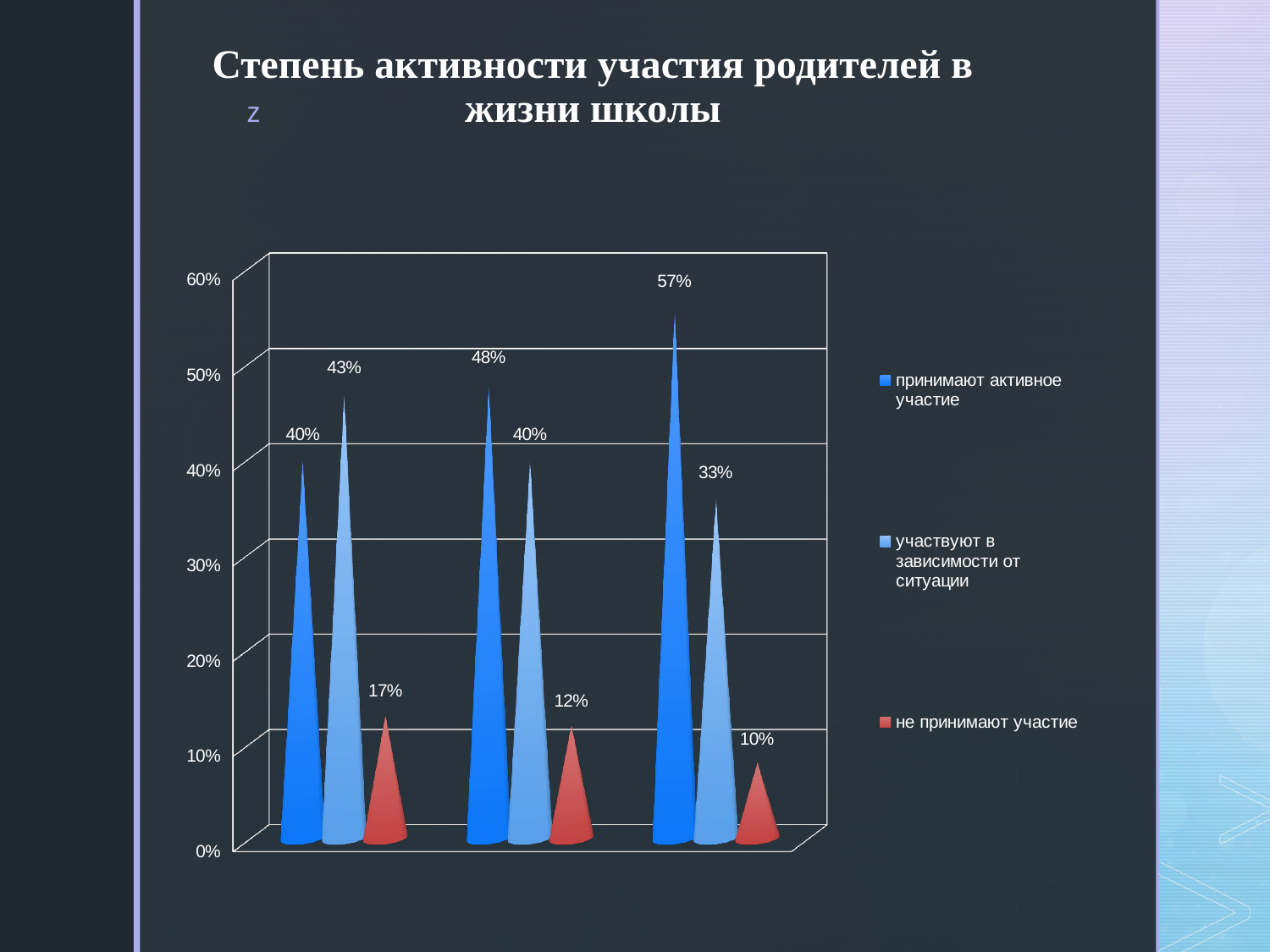
What is the lowest value shown for 'не принимают участие'? 10% Do the values for 'принимают активное участие' rise or fall from the left group to the right group? rise What is the value for 'принимают активное участие' in the third (rightmost) group of bars? 57% What kind of chart is shown on the slide? bar chart How many series does the legend list? 3 What is the value for 'участвуют в зависимости от ситуации' in the second (middle) group of bars? 40% In the first (leftmost) group, which is larger: 'принимают активное участие' or 'участвуют в зависимости от ситуации'? участвуют в зависимости от ситуации What is the value for 'не принимают участие' in the first (leftmost) group of bars? 17% Across all groups, which series has the highest plotted value, and what is it? принимают активное участие, 57% How many groups of bars are plotted along the x axis? 3 What is the difference between 'принимают активное участие' and 'участвуют в зависимости от ситуации' in the third (rightmost) group? 24% What colour represents 'не принимают участие' in the chart? red